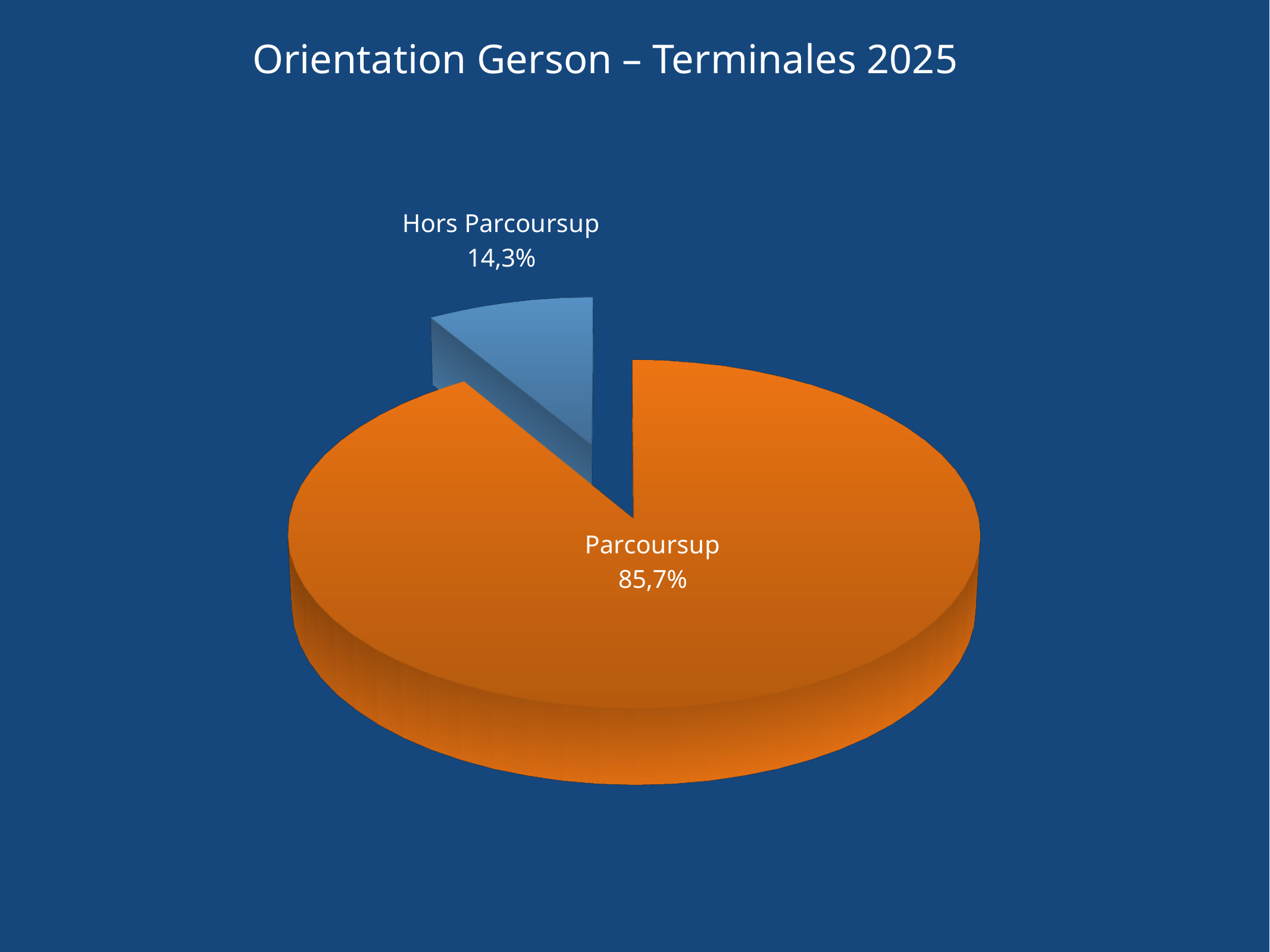
What is the title of the chart? Orientation Gerson – Terminales 2025 Which slice is the smallest? Hors Parcoursup What share of the pie does Hors Parcoursup represent? 14,3% What share of the pie does Parcoursup represent? 85,7% What colour is the Hors Parcoursup slice? Blue What kind of chart is shown on the slide? Pie chart What is the difference in percentage points between the Parcoursup and Hors Parcoursup slices? 71,4 How many slices does the pie chart have? 2 Which slice is the largest? Parcoursup Which is larger, the Parcoursup slice or the Hors Parcoursup slice? Parcoursup